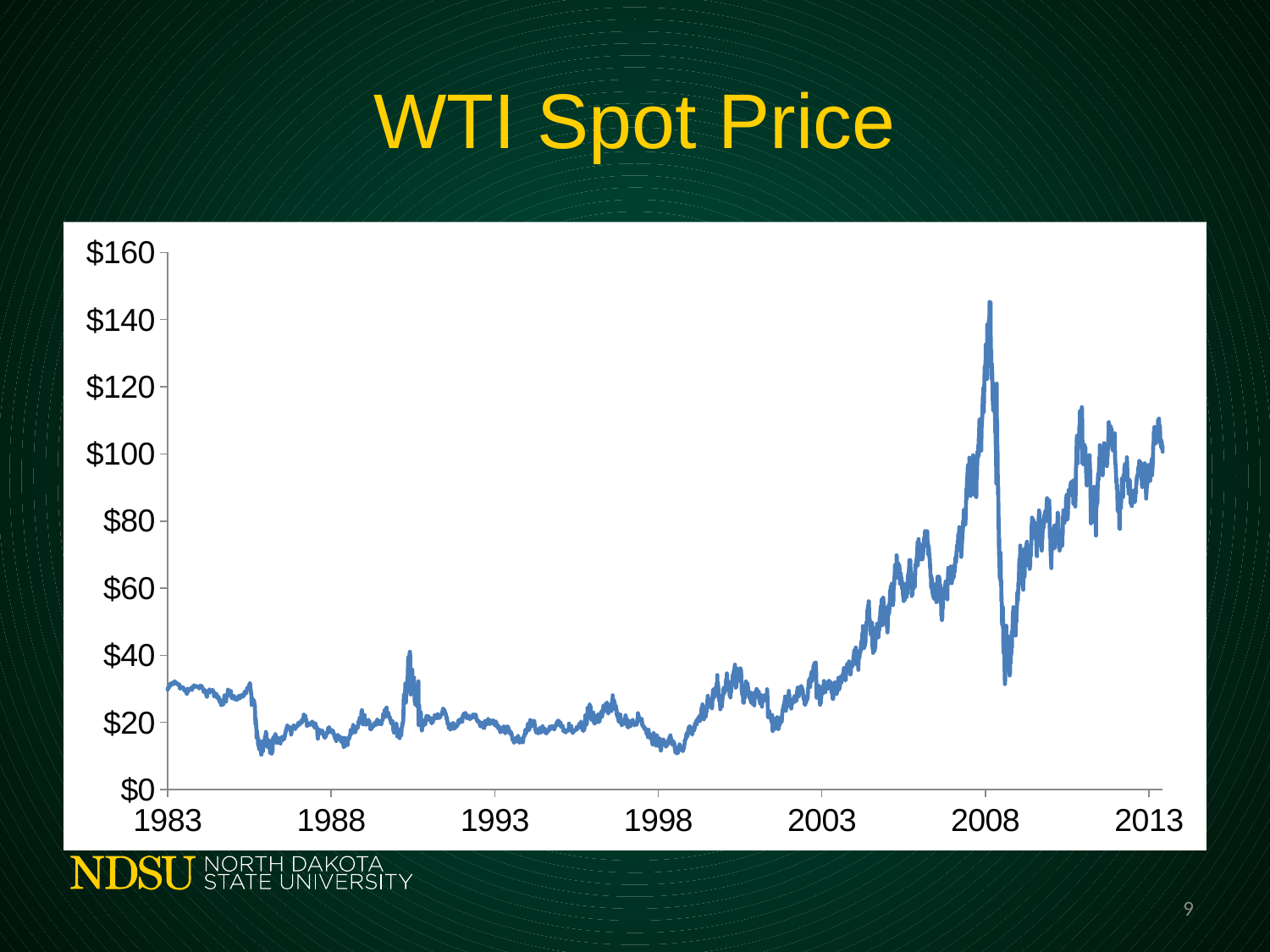
What is the highest value shown on the y axis? $160 Is the WTI spot price around 1998 greater or less than $40? less Is the WTI spot price at the end of the chart in 2013 greater or less than $80? greater Does the WTI spot price generally rise or fall between 2003 and 2008? rise Is the WTI spot price at the start of the chart in 1983 greater or less than $40? less What kind of chart is shown on the slide? line chart How many lines are plotted on the chart? 1 What is the title of the chart? WTI Spot Price Is the WTI spot price in 2013 higher or lower than in 1983? higher In which year labelled on the x axis does the WTI spot price reach its highest peak? 2008